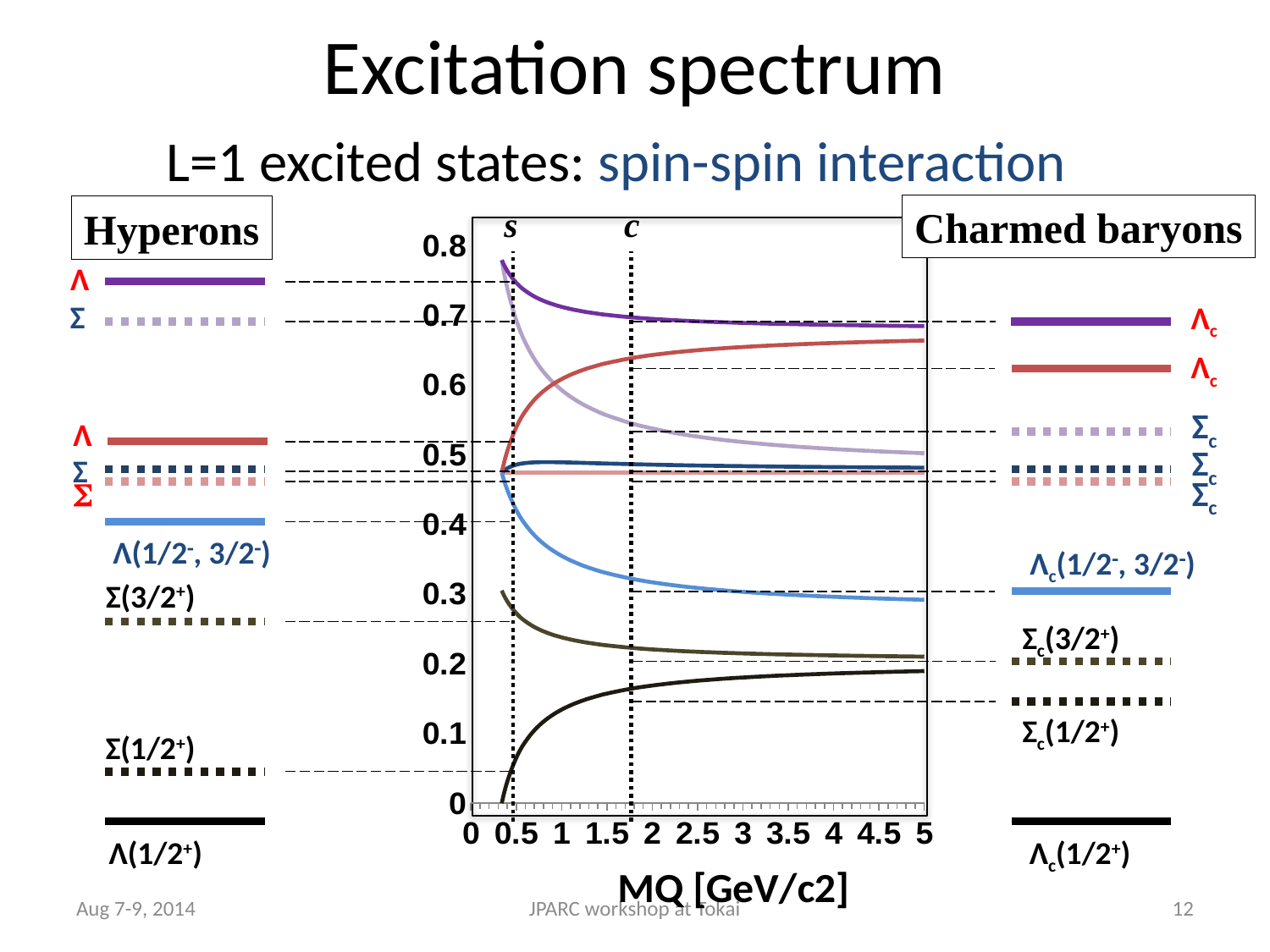
Does the top purple curve rise or fall as MQ increases? fall How many vertical dotted lines are drawn on the chart? 2 Is the value of the red curve at MQ = 5 greater or less than 0.6? greater What kind of chart is shown in the centre of the slide? line chart Does the light blue curve rise or fall as MQ increases? fall Does the red curve that starts near 0.5 rise or fall as MQ increases? rise What is the label of the x axis of the chart? MQ [GeV/c2] Is the value of the light blue curve at MQ = 5 greater or less than 0.4? less Is the value of the lowest black curve at MQ = 1 greater or less than 0.1? greater Which curve has the highest value at MQ = 5, the top purple curve or the red curve? the top purple curve What is the highest tick value shown on the y axis of the chart? 0.8